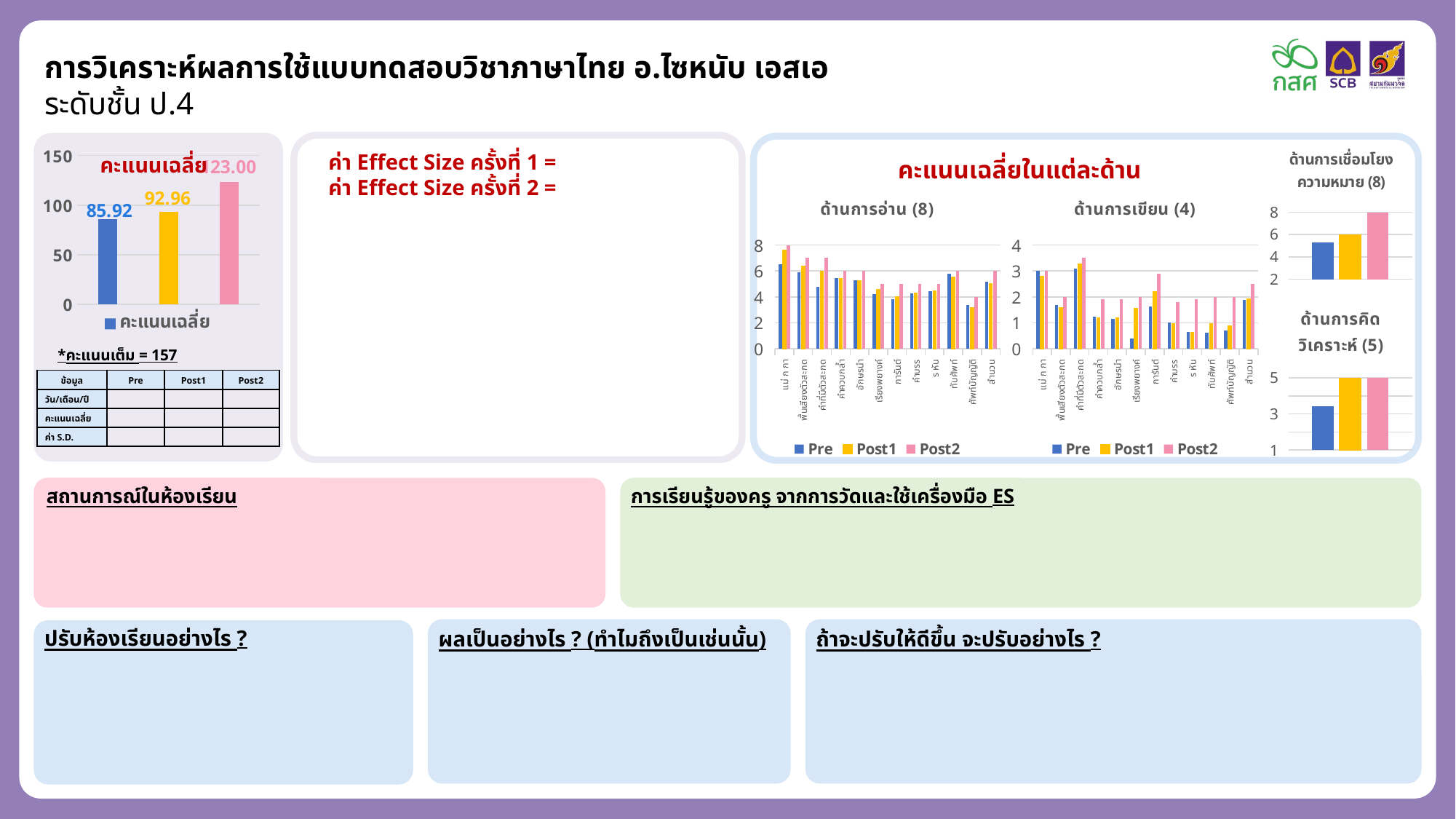
In the chart titled ด้านการคิดวิเคราะห์ (5), which is larger, the Pre value or the Post1 value? Post1 In the chart titled คะแนนเฉลี่ย on the left, do the bar values rise or fall from left to right? Rise In the chart titled ด้านการเชื่อมโยงความหมาย (8), is the Post2 value greater or less than 6? greater How many series does the legend of the chart titled ด้านการอ่าน (8) list? 3 What are the legend entries of the chart titled ด้านการเขียน (4)? Pre, Post1, Post2 What kind of chart is the chart titled ด้านการอ่าน (8)? Bar chart In the chart titled คะแนนเฉลี่ย on the left, what value is labelled on the blue bar? 85.92 In the chart titled คะแนนเฉลี่ย on the left, what value is labelled on the yellow bar? 92.96 In the chart titled คะแนนเฉลี่ย on the left, what is the difference between the yellow bar (92.96) and the blue bar (85.92)? 7.04 In the chart titled คะแนนเฉลี่ย on the left, which bar is the tallest? The pink (third) bar In the chart titled ด้านการเชื่อมโยงความหมาย (8), is the Pre value greater or less than 6? less What is the title of the large panel on the right containing the charts by skill area? คะแนนเฉลี่ยในแต่ละด้าน